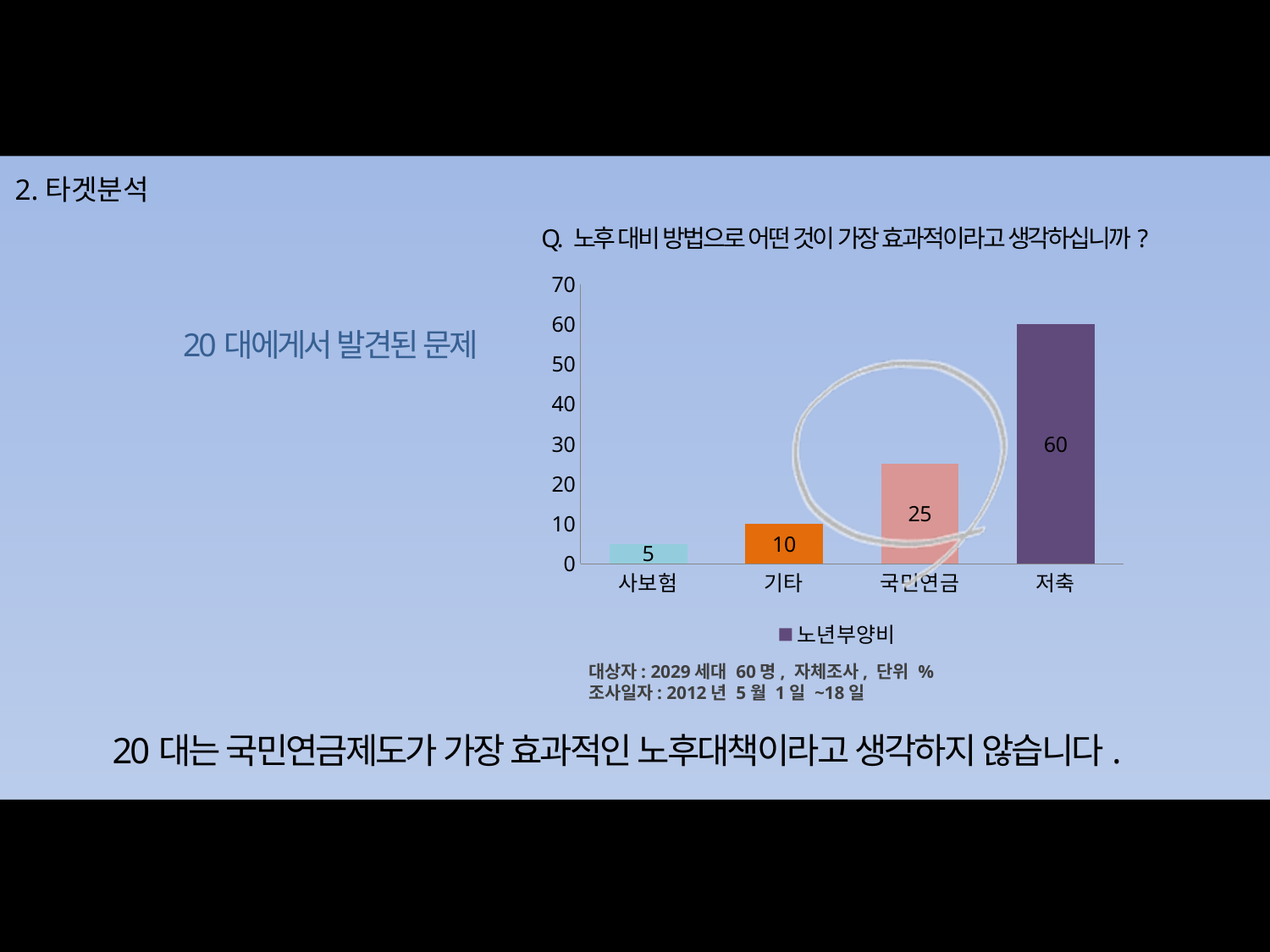
What is the value for 기타? 10 What is the value for 사보험? 5 Which category has the highest value? 저축 Which category has the lowest value? 사보험 How many series does the legend list? 1 How many categories are shown on the x axis? 4 What is the legend entry for the series? 노년부양비 What is the difference between the values for 저축 and 국민연금? 35 Which is larger, the value for 기타 or the value for 국민연금? 국민연금 What kind of chart is shown? bar chart What is the value for 저축? 60 What is the value for 국민연금? 25